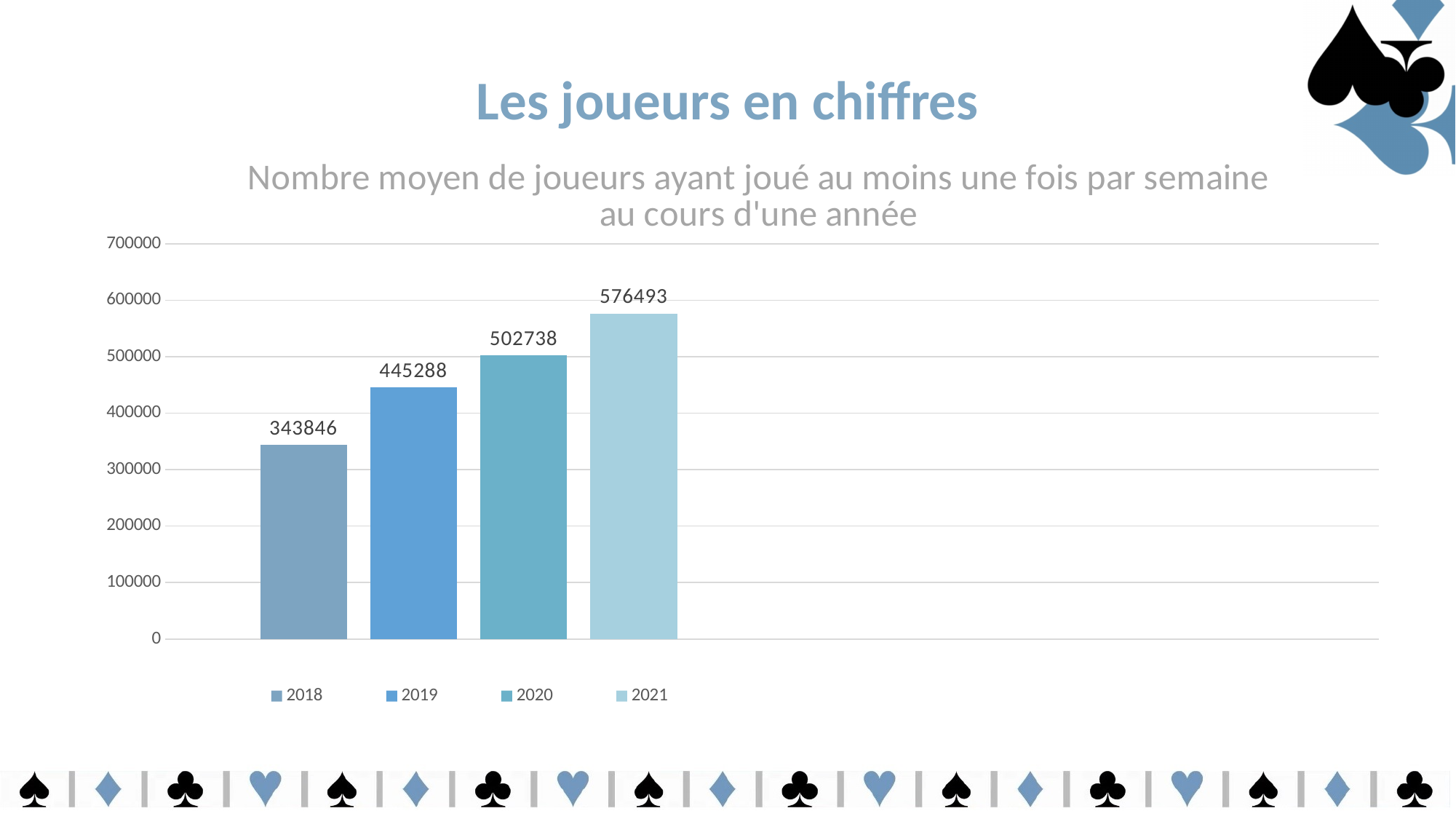
Do the values rise or fall from 2018 to 2021? rise What is the value for 2019? 445288 Which year has the highest value? 2021 What is the value for 2018? 343846 What is the difference between the values for 2020 and 2019? 57450 What is the value for 2021? 576493 Which is larger, the value for 2019 or the value for 2020? 2020 Is the value for 2020 greater or less than 500000? greater Which year has the lowest value? 2018 How many bars are plotted in the chart? 4 What is the difference between the values for 2021 and 2018? 232647 What kind of chart is shown on the slide? bar chart